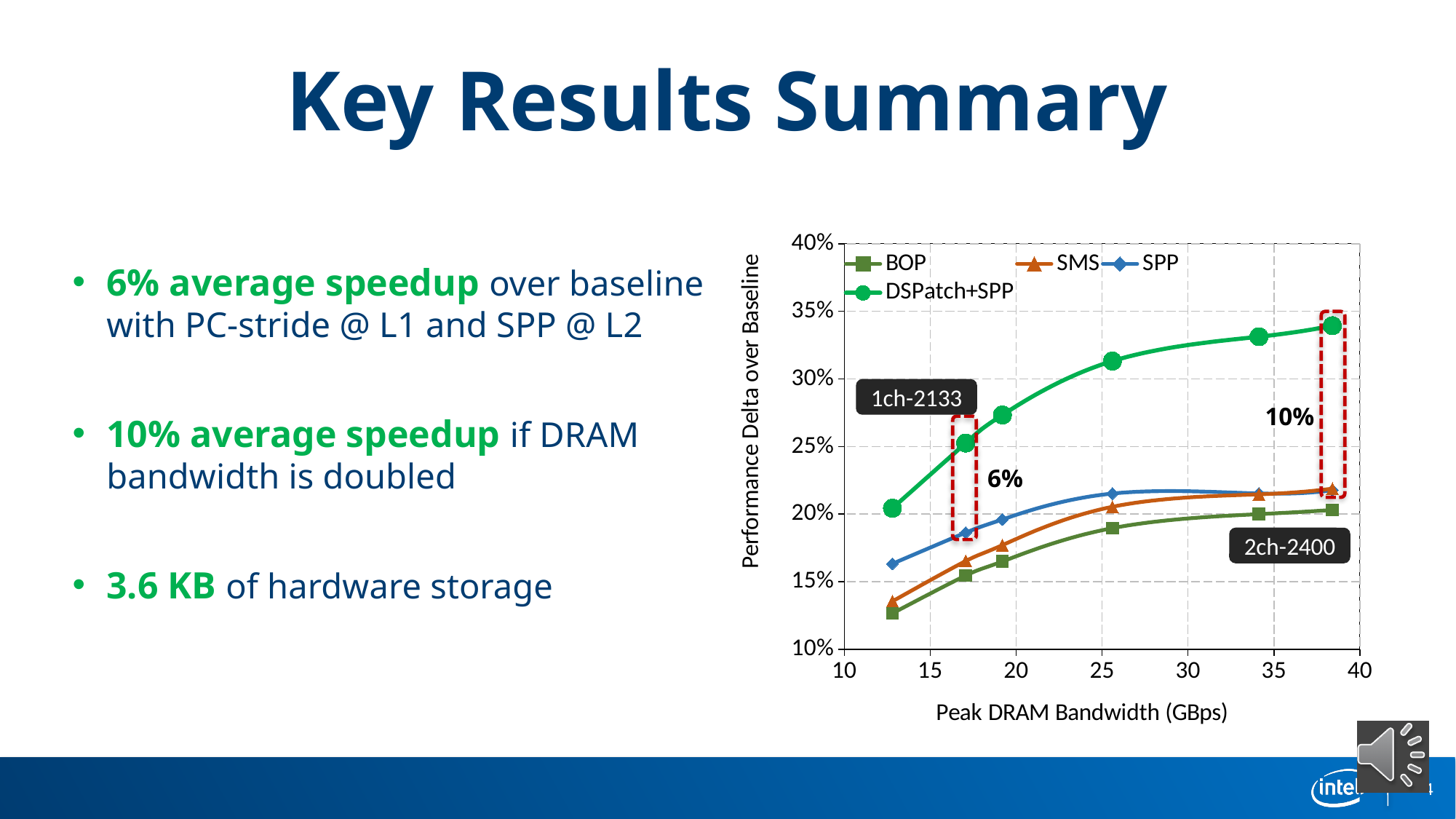
What kind of chart is shown on the slide? line chart Which series has the highest performance delta at the rightmost point of the chart? DSPatch+SPP Is the value for BOP at the leftmost point greater or less than 15%? less How many data points are plotted for the DSPatch+SPP series? 6 Does the DSPatch+SPP series rise or fall as peak DRAM bandwidth increases? rise How many series does the chart legend list? 4 What is the title of the x axis of the chart? Peak DRAM Bandwidth (GBps) What is the title of the y axis of the chart? Performance Delta over Baseline Is the value for SPP at the rightmost point greater or less than 25%? less At the leftmost point, which is larger: the value for SPP or the value for SMS? SPP Is the value for DSPatch+SPP at the rightmost point greater or less than 30%? greater Which series has the lowest performance delta at the leftmost point of the chart? BOP